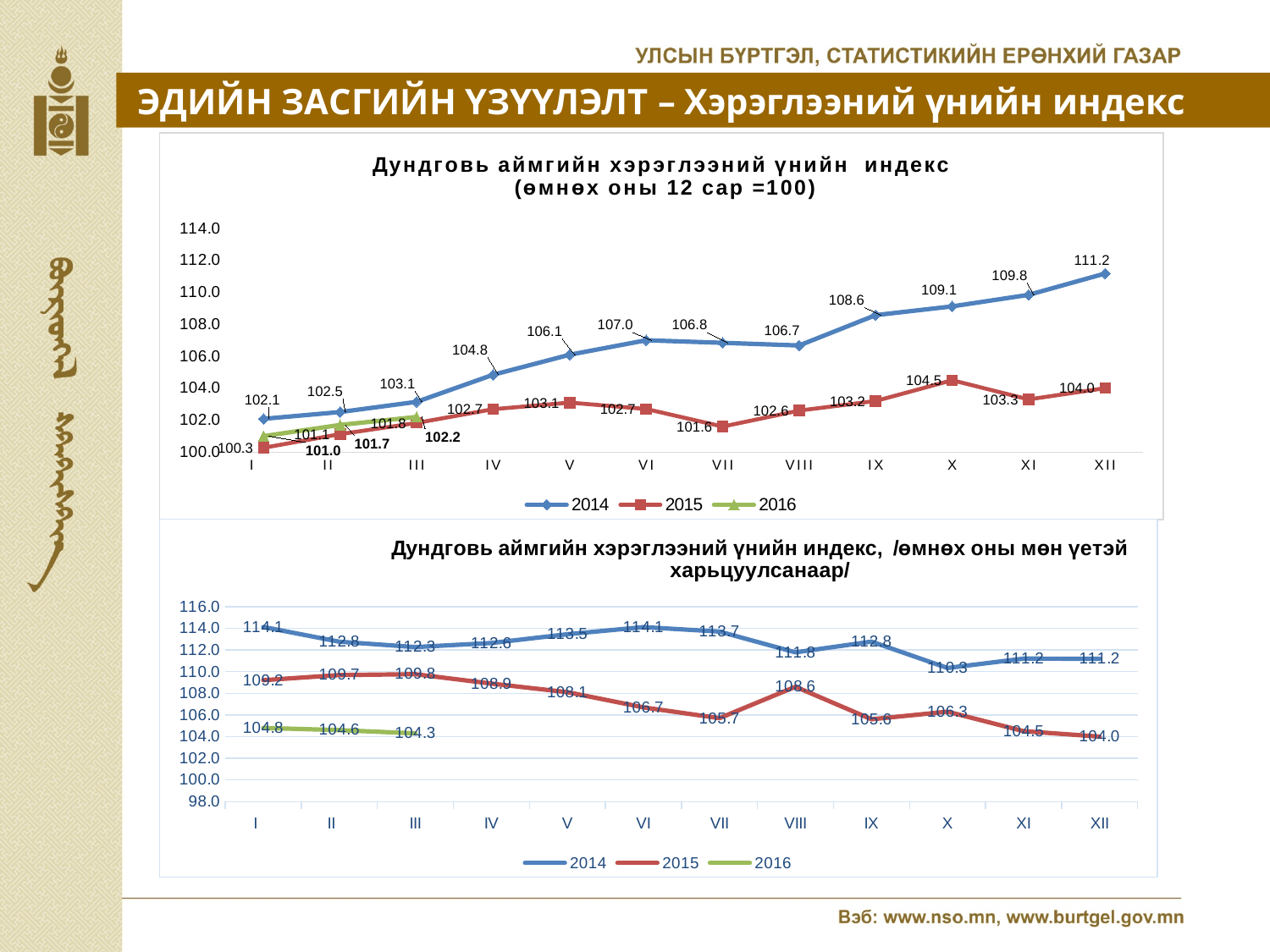
What type of chart is the bottom chart (өмнөх оны мөн үетэй харьцуулсанаар)? Line chart In the top chart (өмнөх оны 12 сар =100), which month has the lowest 2015 value? I In the top chart (өмнөх оны 12 сар =100), what is the difference between the 2014 and 2015 values for month XII? 7.2 In the bottom chart (өмнөх оны мөн үетэй харьцуулсанаар), do the 2016 values rise or fall from month I to month III? Fall In the bottom chart (өмнөх оны мөн үетэй харьцуулсанаар), which is larger for month III: the 2015 value or the 2016 value? 2015 In the bottom chart (өмнөх оны мөн үетэй харьцуулсанаар), what is the 2015 value for month VIII? 108.6 In the top chart (өмнөх оны 12 сар =100), how many series does the legend list? 3 In the top chart (өмнөх оны 12 сар =100), what is the 2014 value for month XII? 111.2 In the bottom chart (өмнөх оны мөн үетэй харьцуулсанаар), how many months are shown on the x axis? 12 In the top chart (өмнөх оны 12 сар =100), what is the 2015 value for month X? 104.5 In the bottom chart (өмнөх оны мөн үетэй харьцуулсанаар), which month has the lowest 2014 value? X In the top chart (өмнөх оны 12 сар =100), what is the 2016 value for month III? 102.2